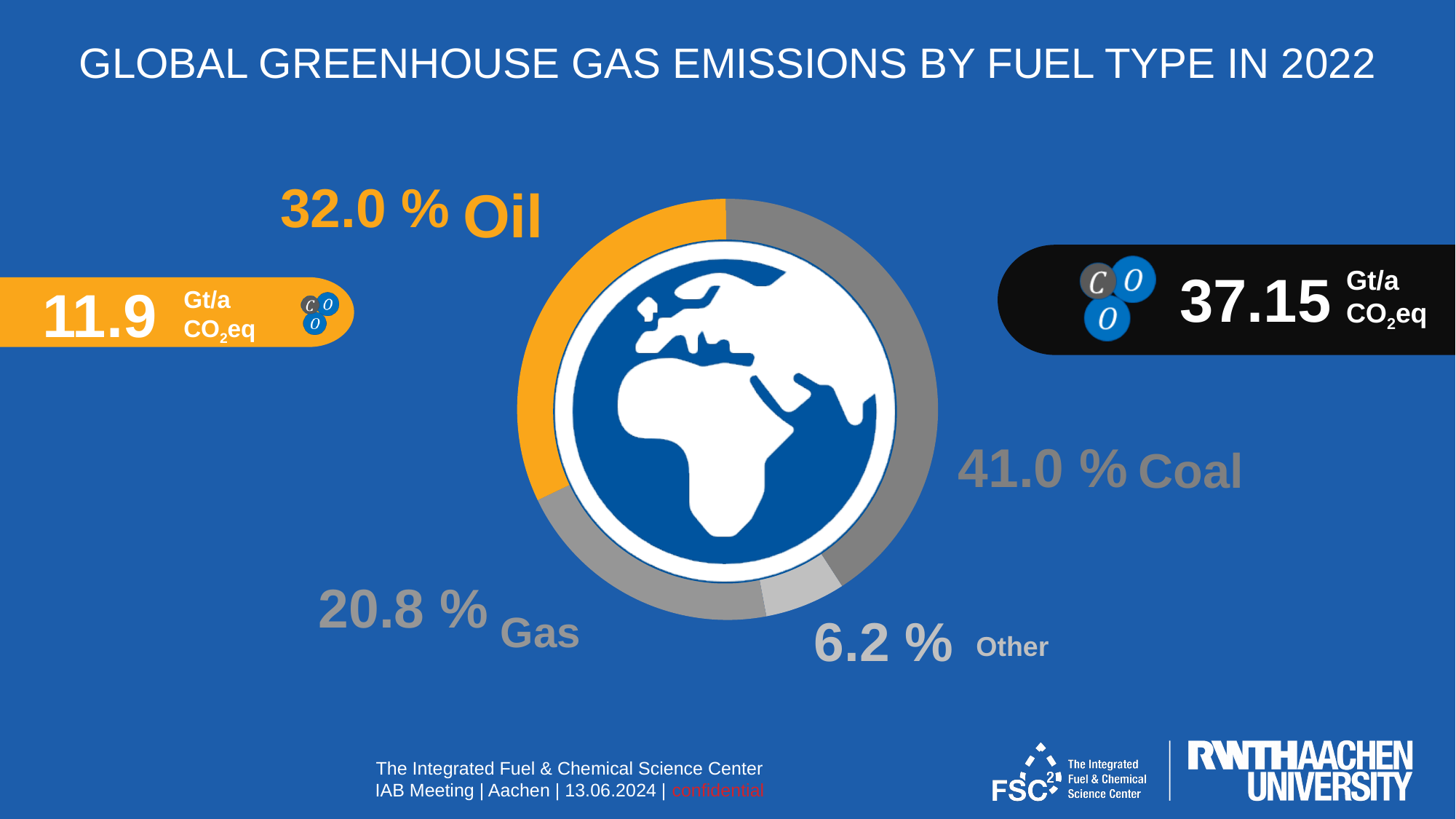
What share of global greenhouse gas emissions by fuel type in 2022 comes from Coal? 41.0 % What share of global greenhouse gas emissions by fuel type in 2022 comes from Other? 6.2 % How many fuel type categories are shown in the chart? 4 What is the difference in percentage points between the Coal share and the Oil share? 9.0 % What colour is the Oil segment of the chart? Orange Which fuel type has the smallest share of global greenhouse gas emissions in 2022? Other Which fuel type has the largest share of global greenhouse gas emissions in 2022? Coal What share of global greenhouse gas emissions by fuel type in 2022 comes from Gas? 20.8 % What share of global greenhouse gas emissions by fuel type in 2022 comes from Oil? 32.0 % Which has a larger share of emissions, Gas or Oil? Oil What total annual greenhouse gas emissions value is shown on the slide? 37.15 Gt/a CO2eq What kind of chart is used to show the emissions by fuel type? Pie chart (donut)